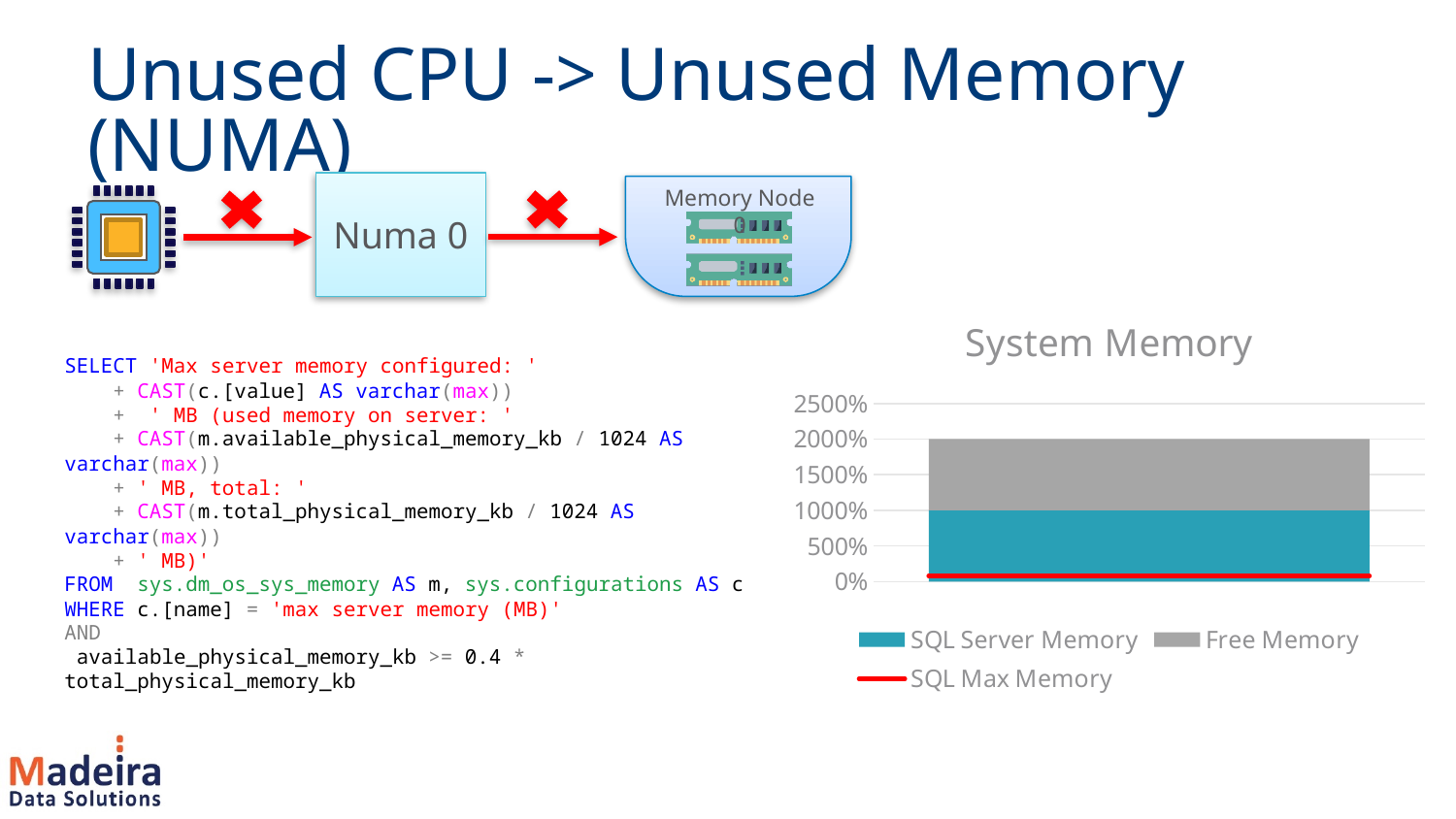
In the System Memory chart, does the top of the stacked bar reach greater or less than 1500%? greater In the System Memory chart, is the SQL Server Memory segment greater or less than 500%? greater In the System Memory chart, which series is shown in gray? Free Memory In the System Memory chart, is the SQL Max Memory line greater or less than 500%? less What kind of chart is the System Memory chart? stacked area chart with a line series What is the title of the chart on the slide? System Memory How many series does the legend of the System Memory chart list? 3 What is the highest value shown on the y axis of the System Memory chart? 2500%